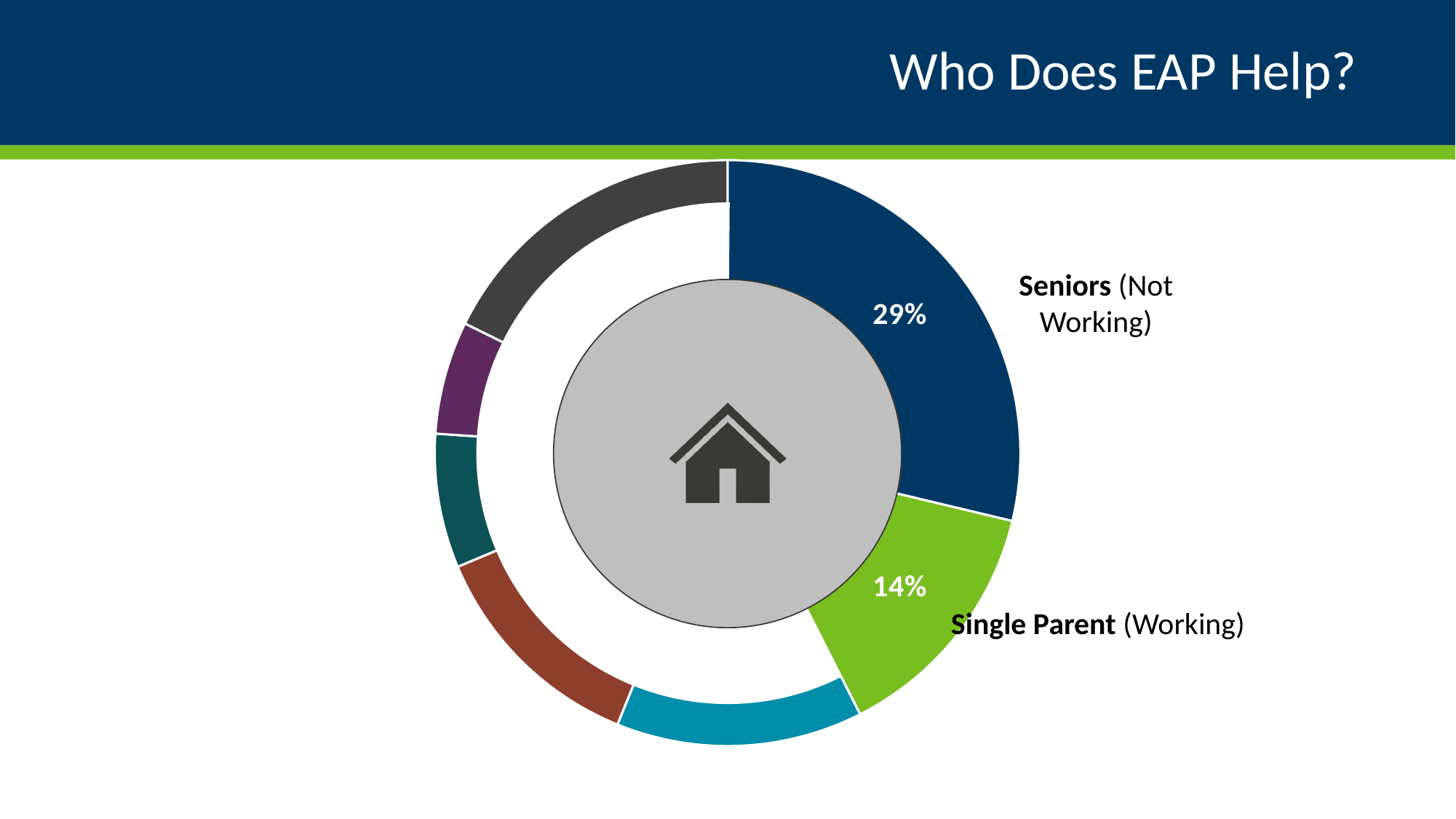
How many segments does the donut chart have? 7 What percentage of the donut chart is labelled for Seniors (Not Working)? 29% What is the title of the slide containing the chart? Who Does EAP Help? What colour is the segment labelled Single Parent (Working)? Green Which is larger: the share for Seniors (Not Working) or the share for Single Parent (Working)? Seniors (Not Working) What kind of chart is shown on the slide? Pie (donut) chart How many segments of the chart have a percentage label printed on them? 2 What percentage of the donut chart is labelled for Single Parent (Working)? 14% What is the difference between the Seniors (Not Working) share and the Single Parent (Working) share? 15% Which labelled category has the largest segment in the chart? Seniors (Not Working)